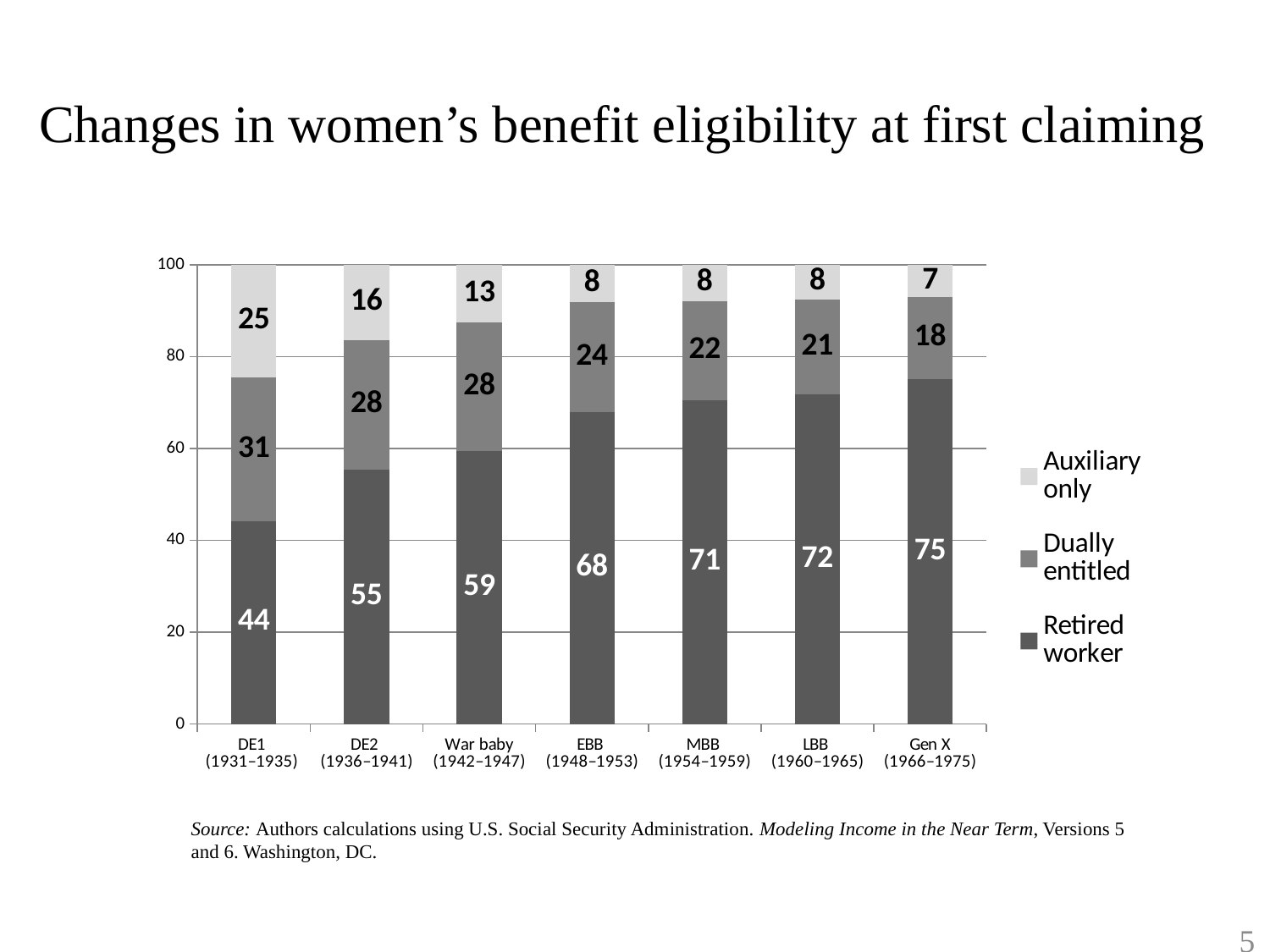
Which cohort has the highest Retired worker value? Gen X (1966–1975) Do the Retired worker values rise or fall from DE1 to Gen X? Rise What is the total of the stacked bar for MBB (1954–1959)? 101 What is the Auxiliary only value for Gen X (1966–1975)? 7 How many cohorts are shown on the x axis? 7 What is the Retired worker value for DE1 (1931–1935)? 44 Which is larger, the Dually entitled value for DE1 (1931–1935) or for EBB (1948–1953)? DE1 (1931–1935) How many series does the legend list? 3 What kind of chart is shown? Stacked bar chart What is the Dually entitled value for War baby (1942–1947)? 28 Which cohort has the lowest Retired worker value? DE1 (1931–1935) What is the difference between the Retired worker values for Gen X (1966–1975) and DE1 (1931–1935)? 31